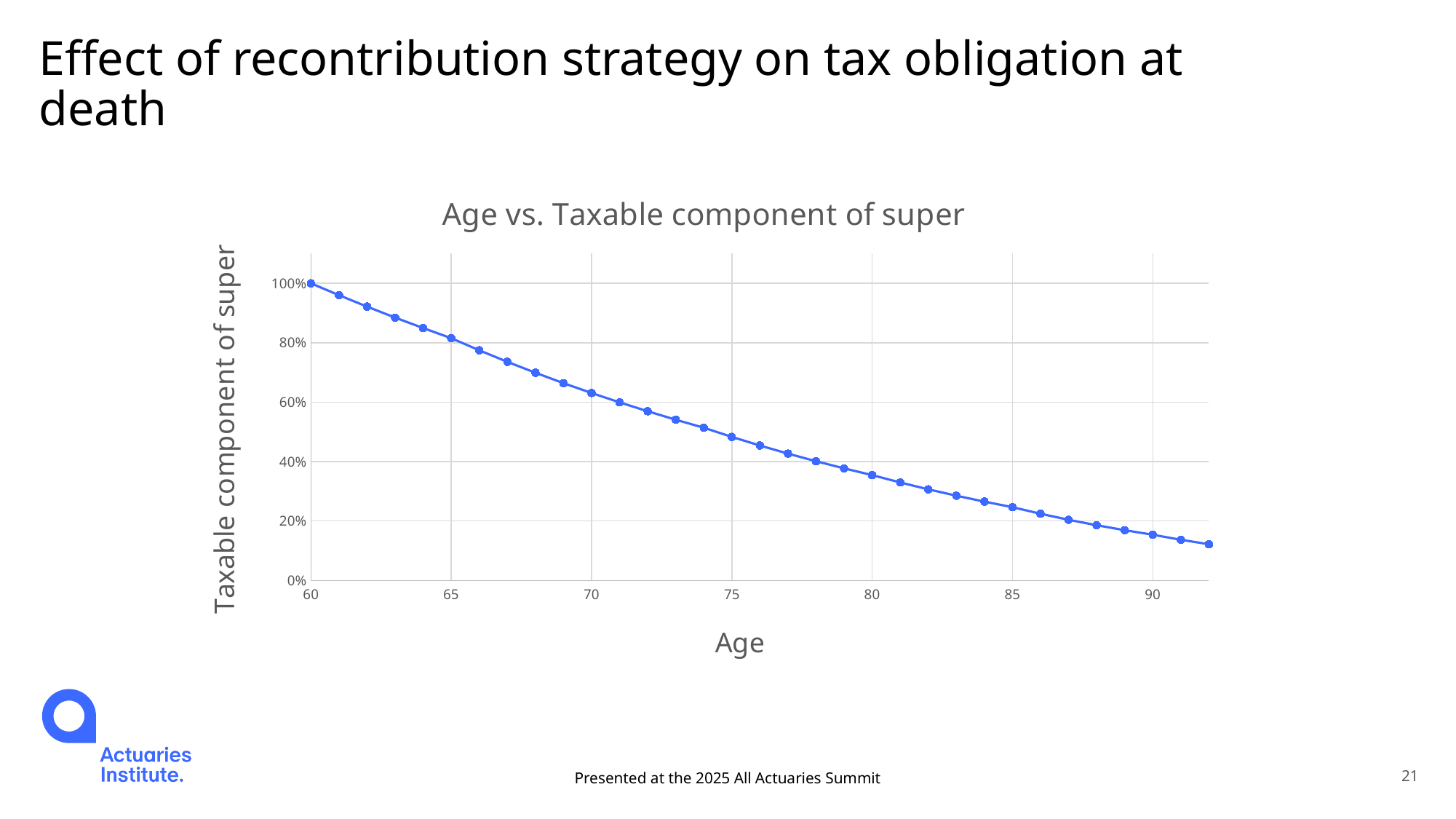
Which is larger, the taxable component of super at age 65 or at age 75? age 65 Is the taxable component of super at age 90 greater or less than 20%? less Is the taxable component of super at age 80 greater or less than 40%? less What is the label of the x axis? Age Is the taxable component of super at age 85 greater or less than 20%? greater What is the title of the chart? Age vs. Taxable component of super Does the taxable component of super rise or fall as age increases? fall At which age is the taxable component of super lowest? 92 At which age is the taxable component of super highest? 60 What is the taxable component of super at age 60? 100% What kind of chart is shown on the slide? line chart